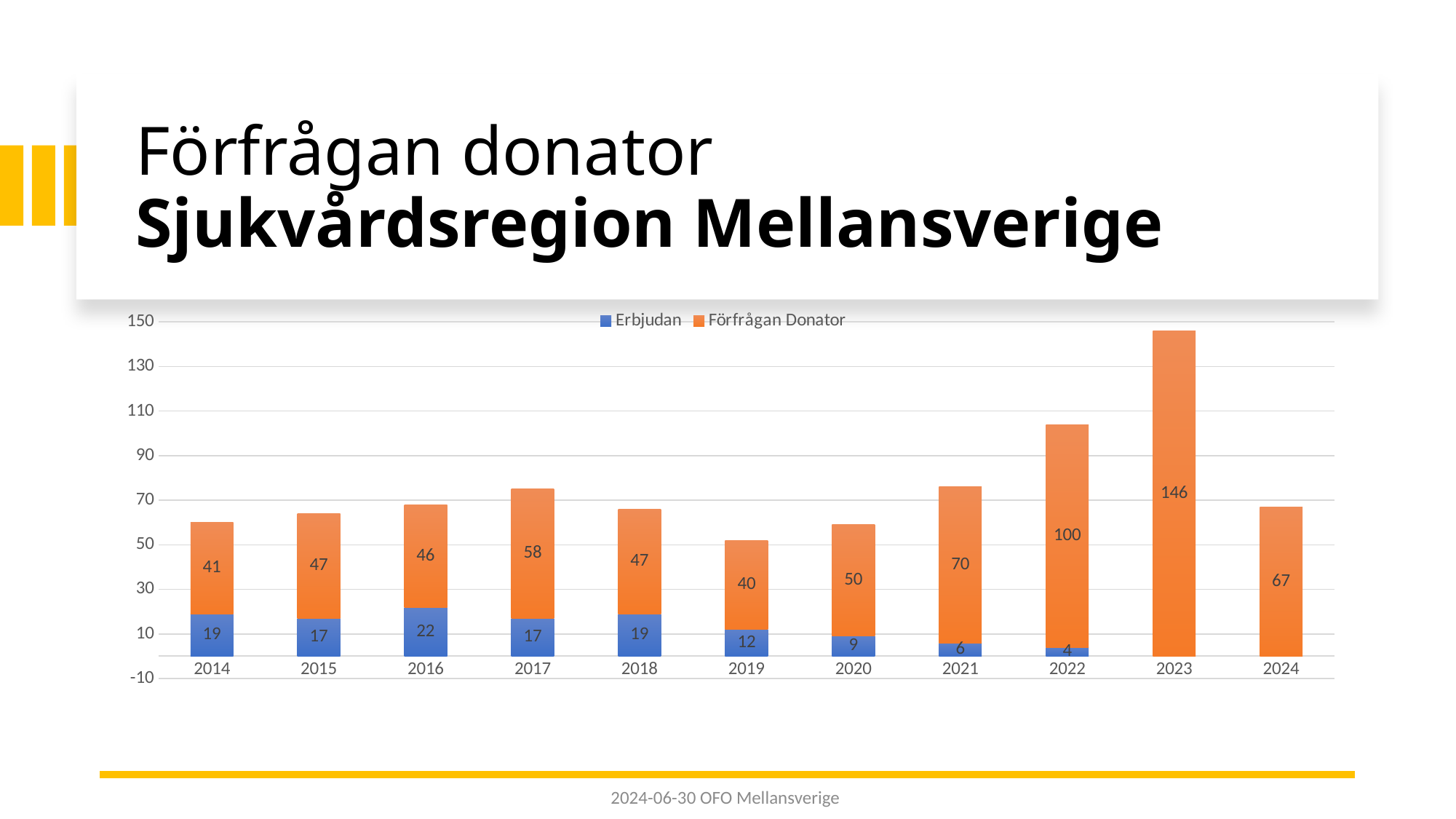
How many years are shown on the x axis? 11 What is the difference between the Förfrågan Donator values for 2022 and 2021? 30 How many series does the legend list? 2 What kind of chart is shown on the slide? Stacked bar chart What is the value of Förfrågan Donator for 2024? 67 What is the value of Erbjudan for 2016? 22 Which is larger, the Erbjudan value for 2014 or for 2019? 2014 What is the value of Förfrågan Donator for 2023? 146 Is the total height of the 2022 stacked bar greater or less than 90? greater Which year has the lowest Erbjudan value among the years where it is shown? 2022 Which year has the highest Förfrågan Donator value? 2023 What is the total of the stacked bar for 2017? 75